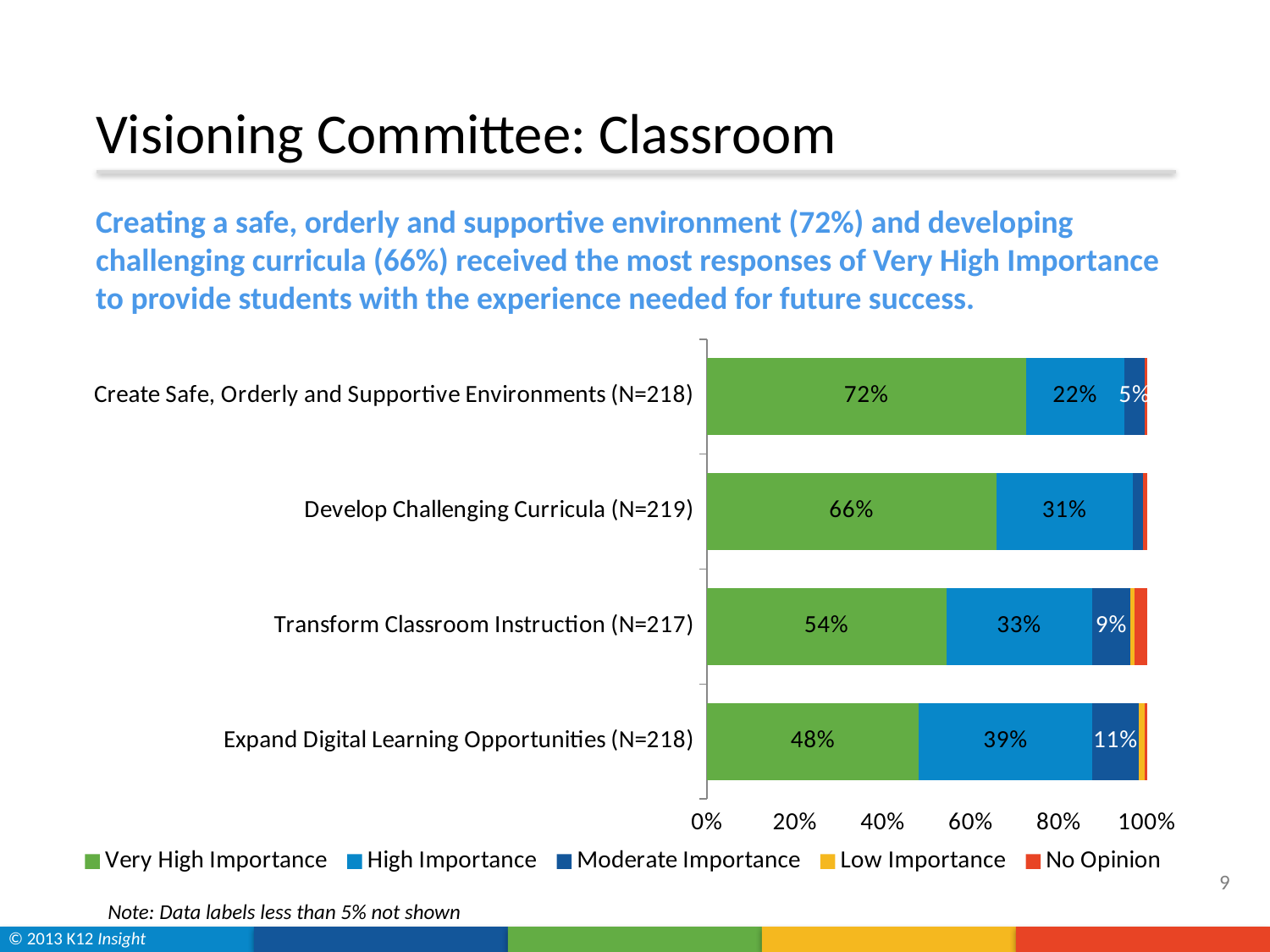
Which is larger: the High Importance value for Develop Challenging Curricula (N=219) or for Transform Classroom Instruction (N=217)? Transform Classroom Instruction (N=217) How many categories are plotted in the chart? 4 How many series does the legend list? 5 What is the Very High Importance value for Create Safe, Orderly and Supportive Environments (N=218)? 72% What is the Moderate Importance value for Transform Classroom Instruction (N=217)? 9% What is the difference between the Very High Importance values for Develop Challenging Curricula (N=219) and Transform Classroom Instruction (N=217)? 12% Is the Very High Importance value for Expand Digital Learning Opportunities (N=218) greater or less than 60%? less What kind of chart is shown on the slide? stacked bar chart Which legend entry is shown in green? Very High Importance Which category has the lowest Very High Importance value? Expand Digital Learning Opportunities (N=218) What is the High Importance value for Expand Digital Learning Opportunities (N=218)? 39% Which category has the highest Very High Importance value? Create Safe, Orderly and Supportive Environments (N=218)